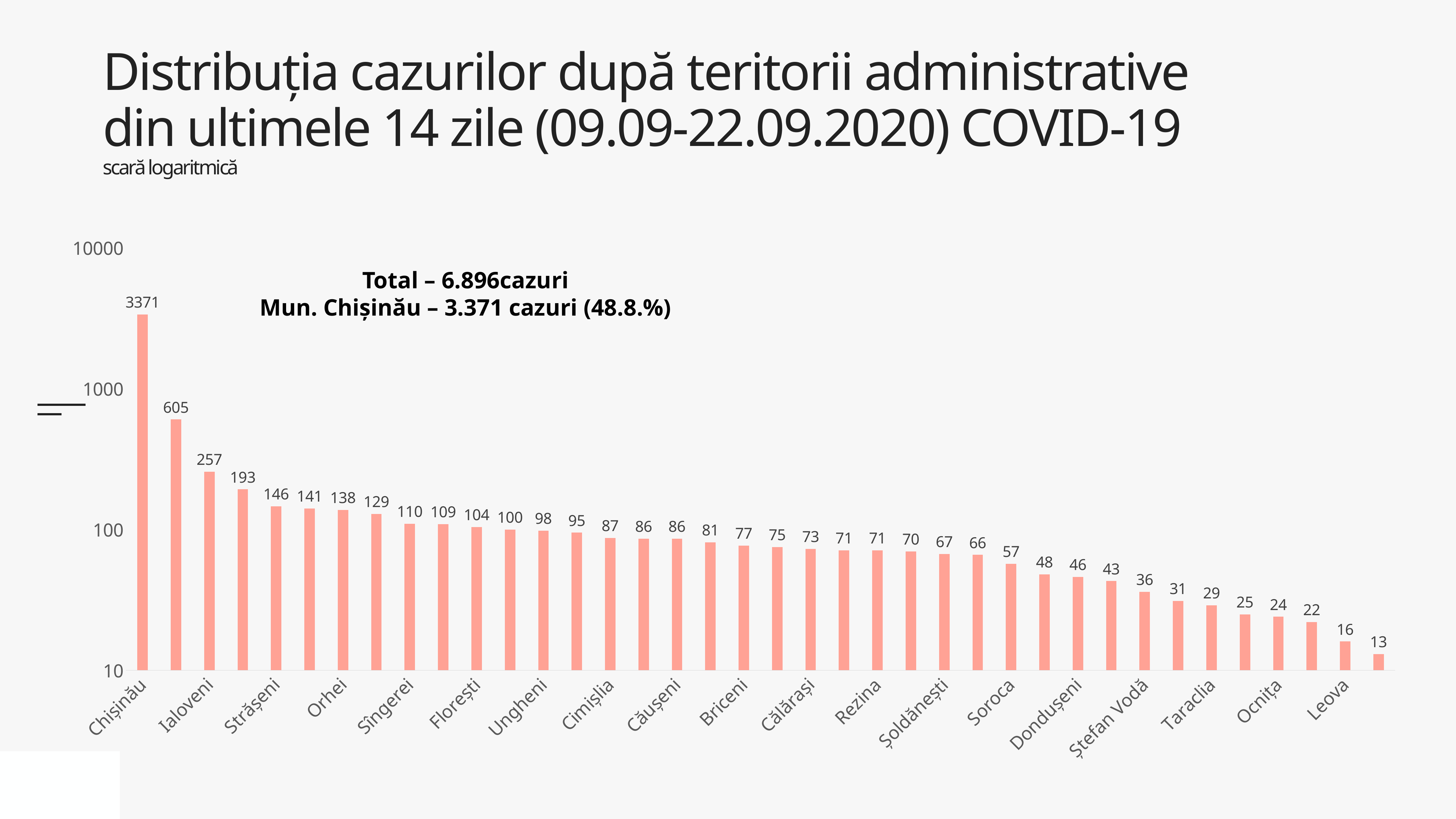
Do the bar values rise or fall from left to right along the x axis? fall What is the value shown for Ialoveni? 257 What is the value shown for Soroca? 57 What is the value shown for Chișinău? 3371 What is the difference between the values for Chișinău and Ialoveni? 3114 What is the smallest value labelled on any bar in the chart? 13 According to the text on the chart, what is the total number of cases? 6.896 How many bars are plotted in the chart? 38 Which territory has the highest number of cases in the chart? Chișinău What is the value shown for Strășeni? 146 What kind of chart is shown on the slide? bar chart Which has a larger value, Orhei or Soroca? Orhei